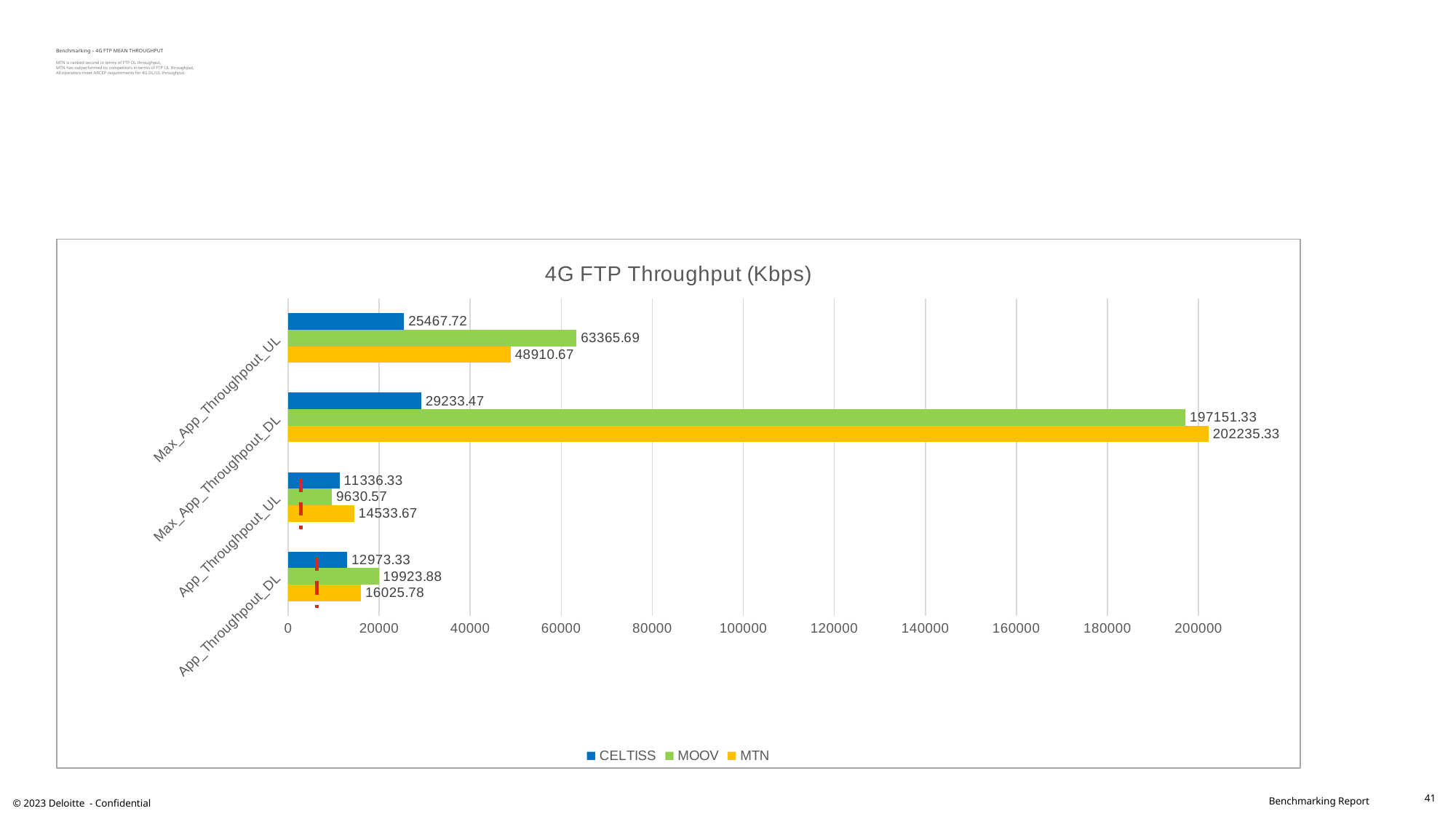
What is the CELTISS value for App_Throughpout_UL? 11336.33 Which operator has the highest value for App_Throughpout_UL? MTN What is the difference between the MTN and MOOV values for Max_App_Throughpout_DL? 5084.00 Which is larger for Max_App_Throughpout_UL: the MOOV value or the MTN value? MOOV How many series does the legend list? 3 How many categories are shown on the chart? 4 What is the MOOV value for App_Throughpout_DL? 19923.88 Which operator has the lowest value for Max_App_Throughpout_DL? CELTISS What is the MTN value for Max_App_Throughpout_DL? 202235.33 What type of chart is shown on the slide? Bar chart What is the difference between the MOOV and CELTISS values for App_Throughpout_DL? 6950.55 What is the MOOV value for Max_App_Throughpout_UL? 63365.69